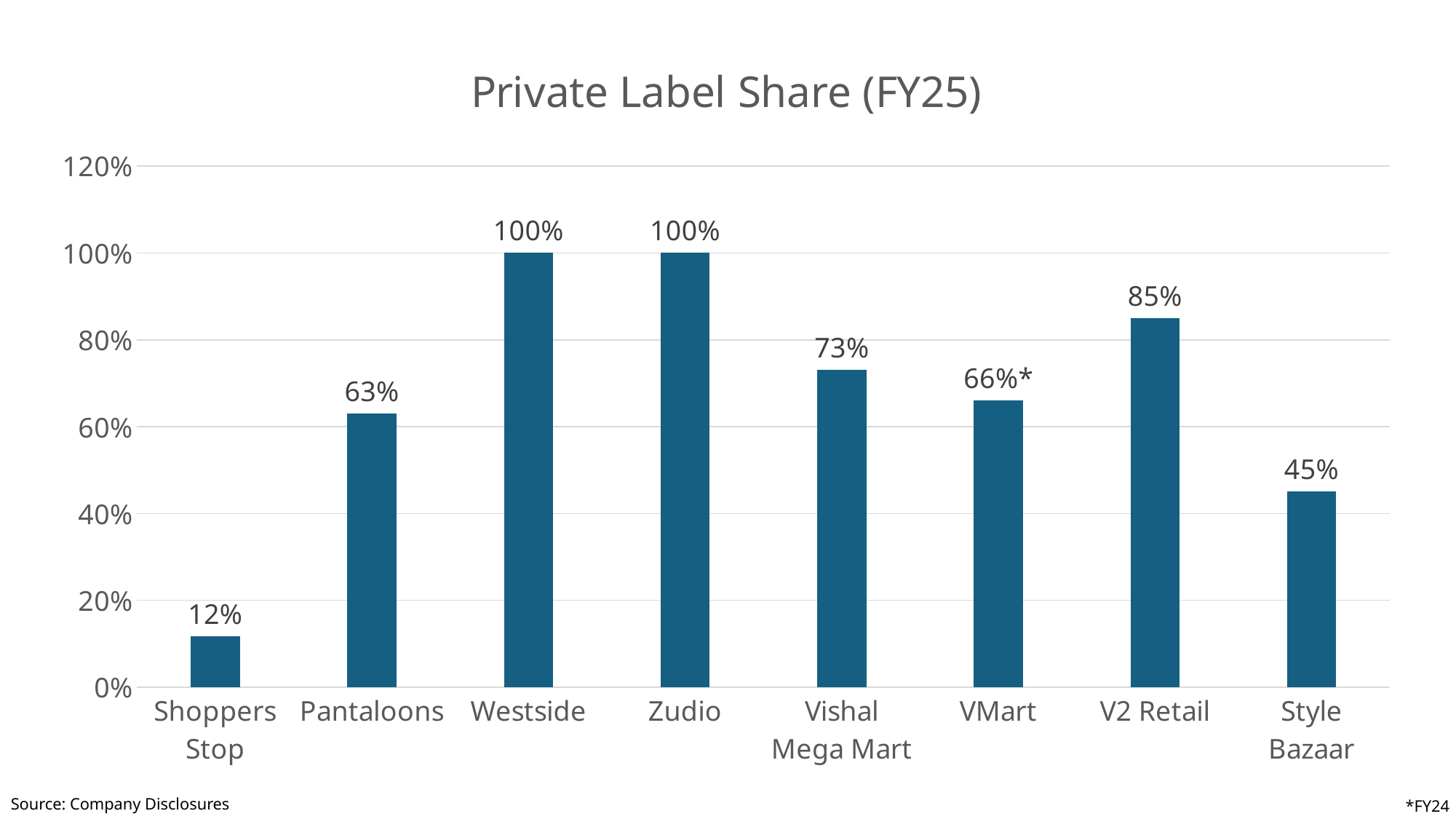
What is the private label share for Pantaloons? 63% What is the difference between the private label share of V2 Retail and Style Bazaar? 40% What kind of chart is shown on the slide? Bar chart What is the private label share for V2 Retail? 85% Which retailer's value is marked with an asterisk indicating FY24 data? VMart What is the title of the chart? Private Label Share (FY25) How many retailers are shown in the chart? 8 What is the private label share for Style Bazaar? 45% What is the private label share for Vishal Mega Mart? 73% Which has a higher private label share, Vishal Mega Mart or VMart? Vishal Mega Mart Which retailer has the lowest private label share? Shoppers Stop Which retailers have the highest private label share? Westside and Zudio